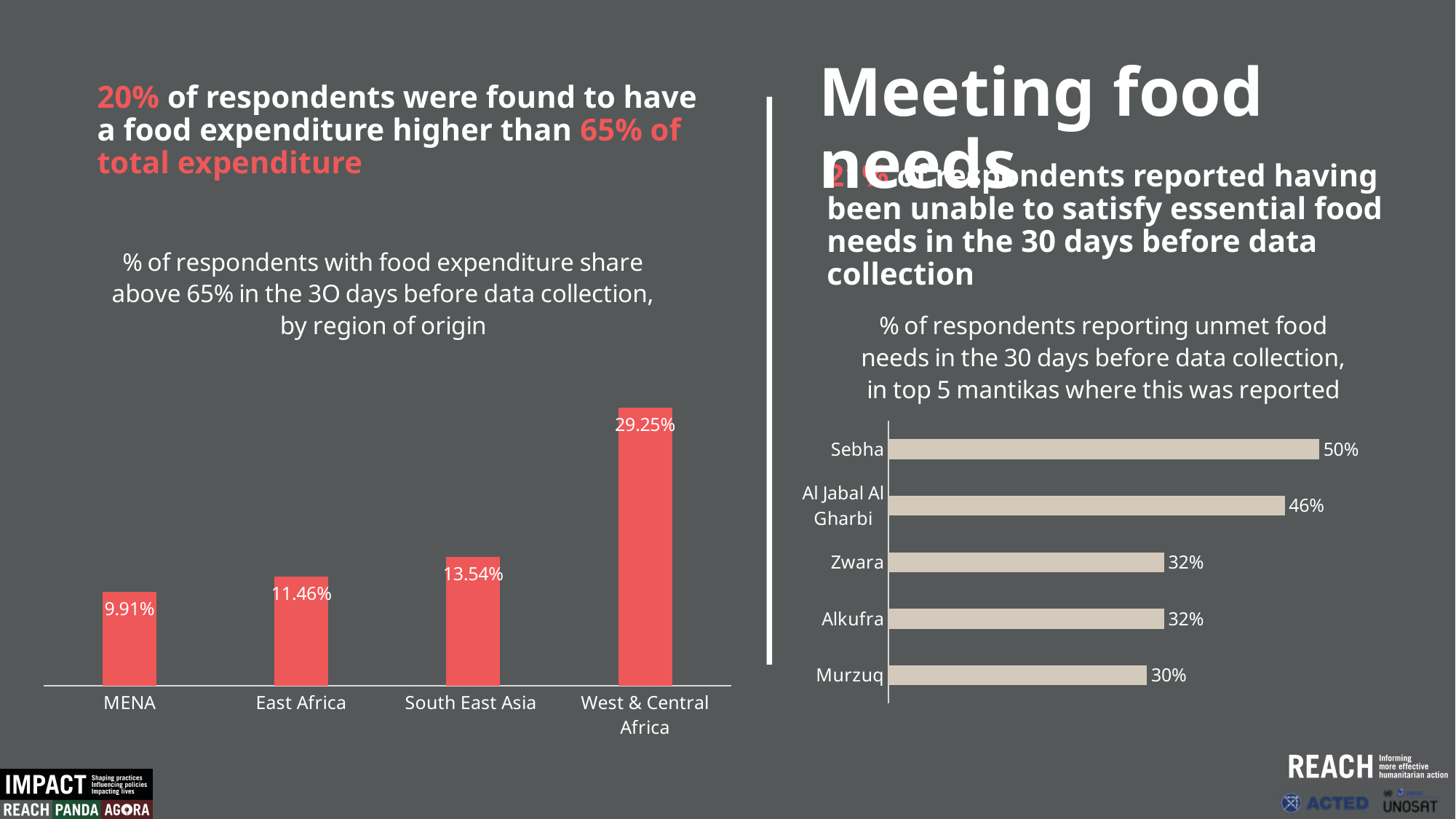
In the left chart (food expenditure share above 65% by region of origin), which region has the highest value? West & Central Africa What kind of chart is the right chart (% of respondents reporting unmet food needs in top 5 mantikas)? bar chart In the right chart (% of respondents reporting unmet food needs in top 5 mantikas), what is the difference between Sebha and Murzuq? 20% In the left chart (food expenditure share above 65% by region of origin), do the values rise or fall from MENA to West & Central Africa? rise In the left chart (food expenditure share above 65% by region of origin), which region has the lowest value? MENA In the right chart (% of respondents reporting unmet food needs in top 5 mantikas), what is the value for Al Jabal Al Gharbi? 46% In the left chart (food expenditure share above 65% by region of origin), how many regions are shown? 4 In the right chart (% of respondents reporting unmet food needs in top 5 mantikas), which mantika has the lowest value? Murzuq In the right chart (% of respondents reporting unmet food needs in top 5 mantikas), what is the value for Sebha? 50% In the left chart (food expenditure share above 65% by region of origin), what is the value for South East Asia? 13.54% In the left chart (food expenditure share above 65% by region of origin), what is the difference between West & Central Africa and East Africa? 17.79% In the left chart (% of respondents with food expenditure share above 65%, by region of origin), what is the value for MENA? 9.91%